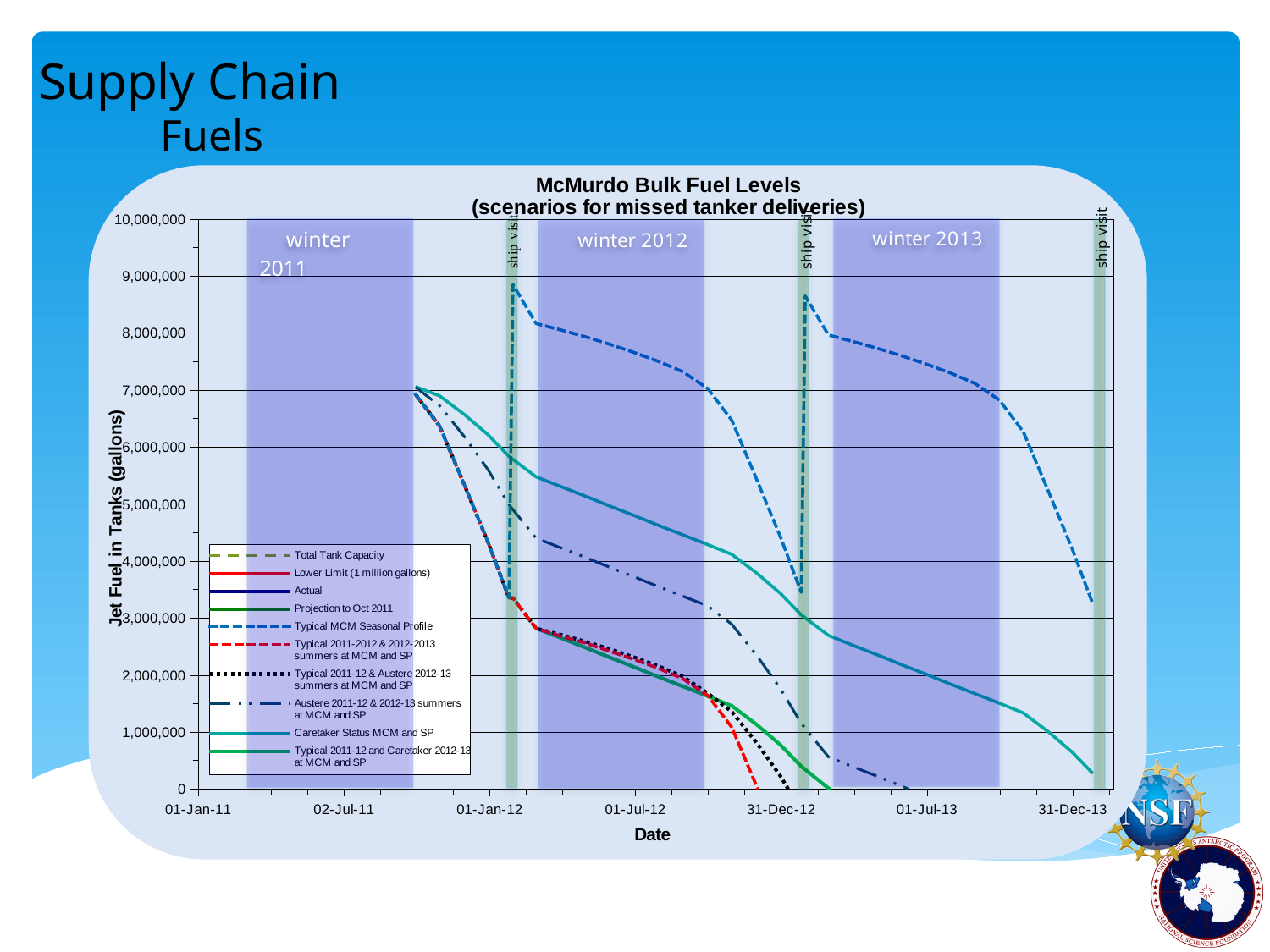
At 31-Dec-13, which line is higher: Typical MCM Seasonal Profile or Caretaker Status MCM and SP? Typical MCM Seasonal Profile Is the value of the Typical MCM Seasonal Profile line at its peak near 01-Jan-12 greater or less than 8,000,000? greater Is the value of the Caretaker Status MCM and SP line at 31-Dec-13 greater or less than 1,000,000? less What kind of chart is shown on the slide? Line chart How many series does the chart legend list? 10 Does the Caretaker Status MCM and SP line rise or fall from 01-Jan-12 to 31-Dec-13? Fall What is the label of the vertical axis? Jet Fuel in Tanks (gallons) What is the highest value shown on the vertical axis? 10,000,000 What is the title of the chart? McMurdo Bulk Fuel Levels (scenarios for missed tanker deliveries) Is the value of the Typical MCM Seasonal Profile line at 31-Dec-13 greater or less than 3,000,000? greater